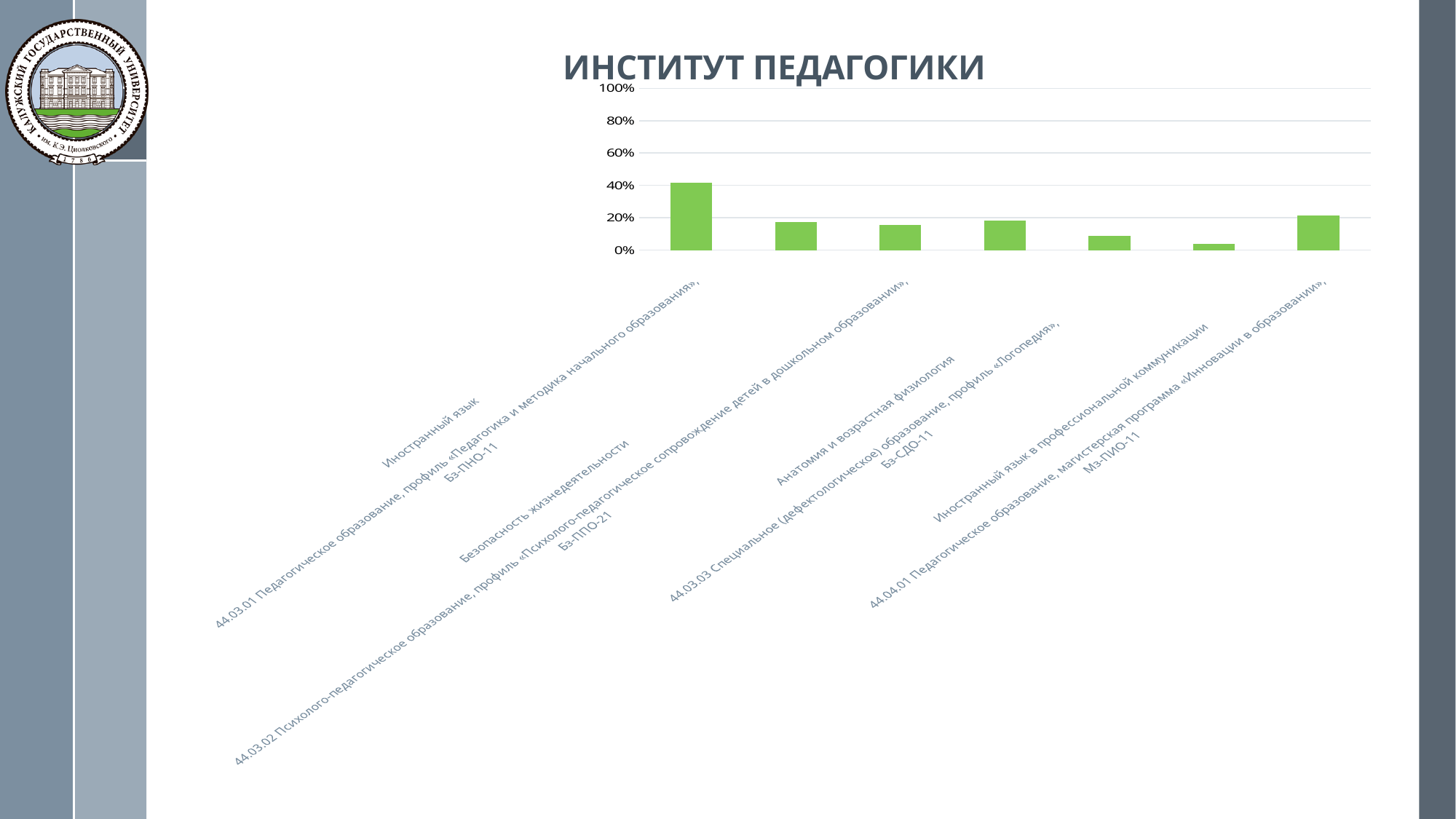
Is the value of the fifth bar from the left greater or less than 20%? less Which bar is the lowest in the chart? the sixth bar from the left What is the highest value shown on the vertical axis of the chart? 100% Which is larger, the first bar from the left or the last bar on the right? the first bar from the left Is the value of the first bar from the left greater or less than 60%? less What is the title of the slide with the chart? ИНСТИТУТ ПЕДАГОГИКИ Is the value of the sixth bar from the left greater or less than 20%? less How many bars are plotted in the chart? 7 Which bar is the highest in the chart? the first bar from the left What kind of chart is shown on the slide? bar chart Which is larger, the fifth bar from the left or the sixth bar from the left? the fifth bar from the left